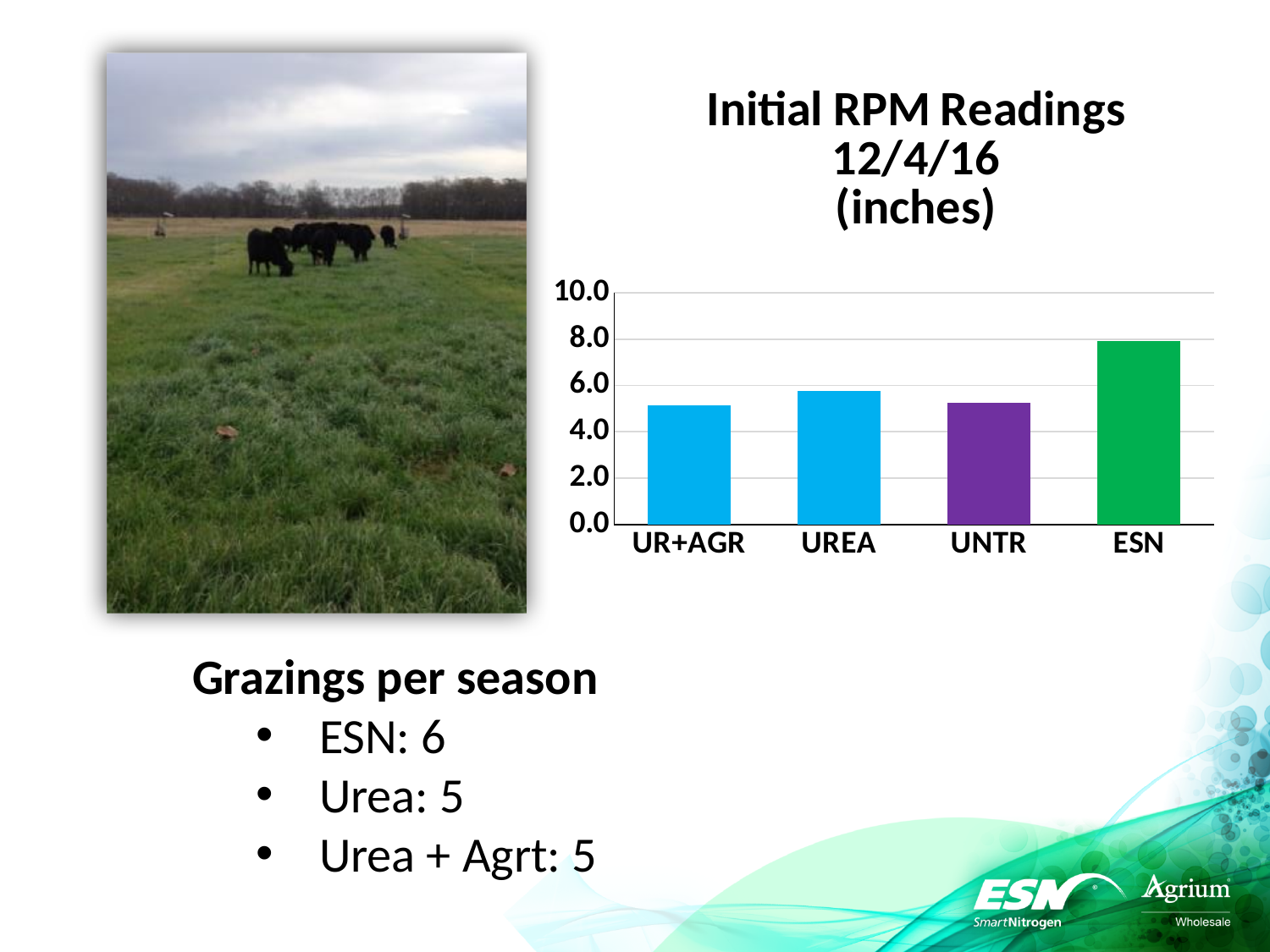
What kind of chart is shown on the slide? bar chart Is the value for UNTR greater or less than 6.0? less What unit is given in the chart title for the RPM readings? inches What date is shown in the chart title? 12/4/16 Is the value for ESN greater or less than 6.0? greater Is the value for UREA greater or less than 4.0? greater Which category has the highest initial RPM reading? ESN How many categories are plotted in the Initial RPM Readings chart? 4 Which is larger, the value for ESN or the value for UREA? ESN Which is larger, the value for UREA or the value for UR+AGR? UREA